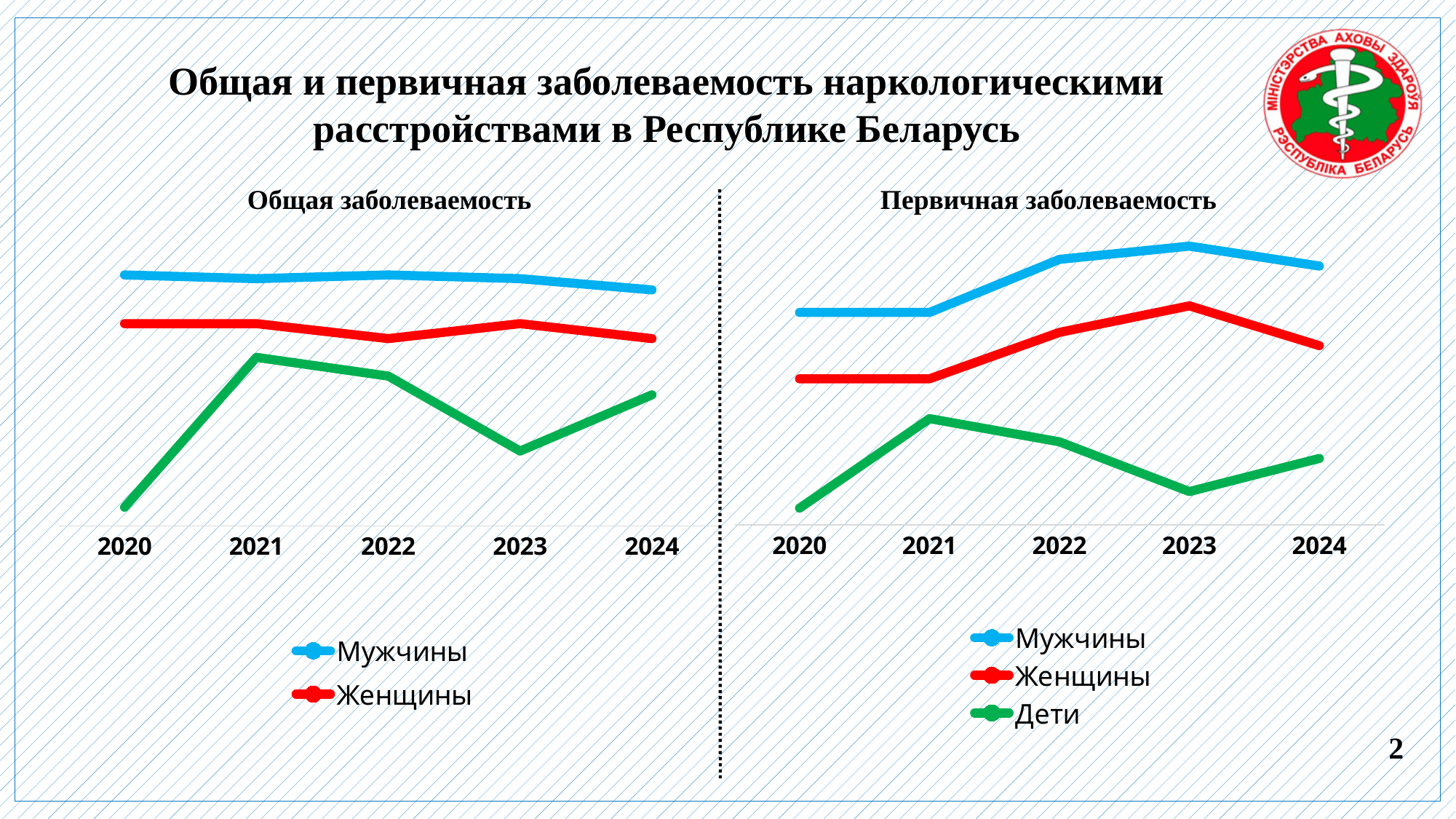
In the left chart "Общая заболеваемость", how many years are shown on the x axis? 5 In the right chart "Первичная заболеваемость", in which year is the Женщины line at its highest? 2023 In the right chart "Первичная заболеваемость", in which year is the Мужчины line at its highest? 2023 What kind of chart is the left chart titled "Общая заболеваемость"? line chart In the left chart "Общая заболеваемость", which is higher in 2024: Мужчины or Женщины? Мужчины How many series does the legend of the right chart "Первичная заболеваемость" list? 3 In the left chart "Общая заболеваемость", in which year is the green line at its lowest? 2020 In the right chart "Первичная заболеваемость", in which year is the Дети line at its lowest? 2020 In the right chart "Первичная заболеваемость", does the Мужчины line rise or fall from 2020 to 2023? rise How many series does the legend of the left chart "Общая заболеваемость" list? 2 In the left chart "Общая заболеваемость", in which year is the green line at its highest? 2021 What is the title of the chart on the right side of the slide? Первичная заболеваемость